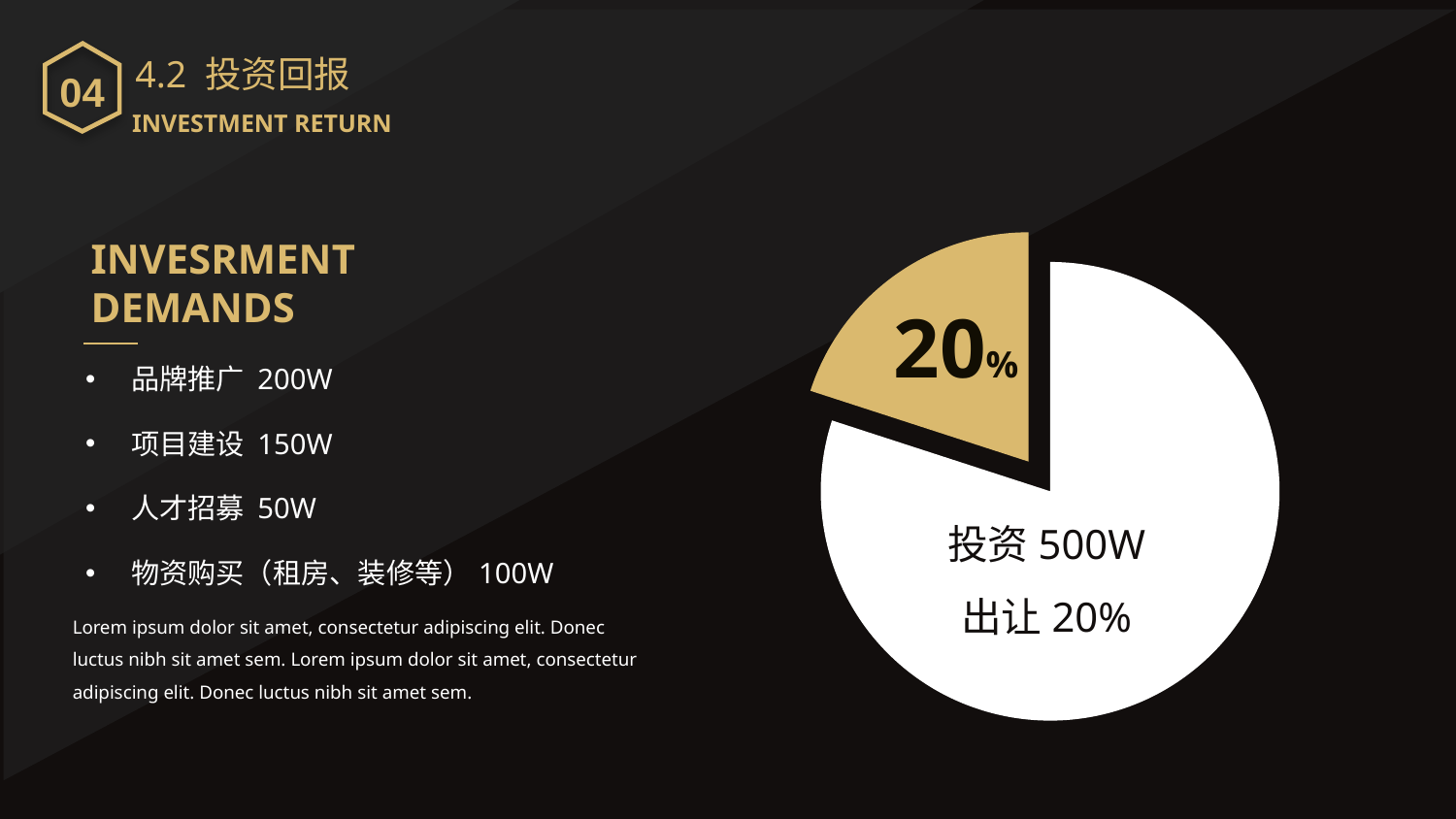
What percentage is labelled on the gold slice of the pie chart? 20% Is the gold slice of the pie chart greater or less than 50% of the pie? less Which slice of the pie chart is the smallest? the gold slice (20%) What kind of chart is shown on the slide? pie chart Is the white slice of the pie chart greater or less than 50% of the pie? greater What share is stated as 出让 (equity offered) inside the pie chart? 20% What investment amount is written inside the pie chart? 投资 500W Which slice of the pie chart is larger, the gold slice or the white slice? the white slice What colour is the 20% slice of the pie chart? gold How many slices does the pie chart have? 2